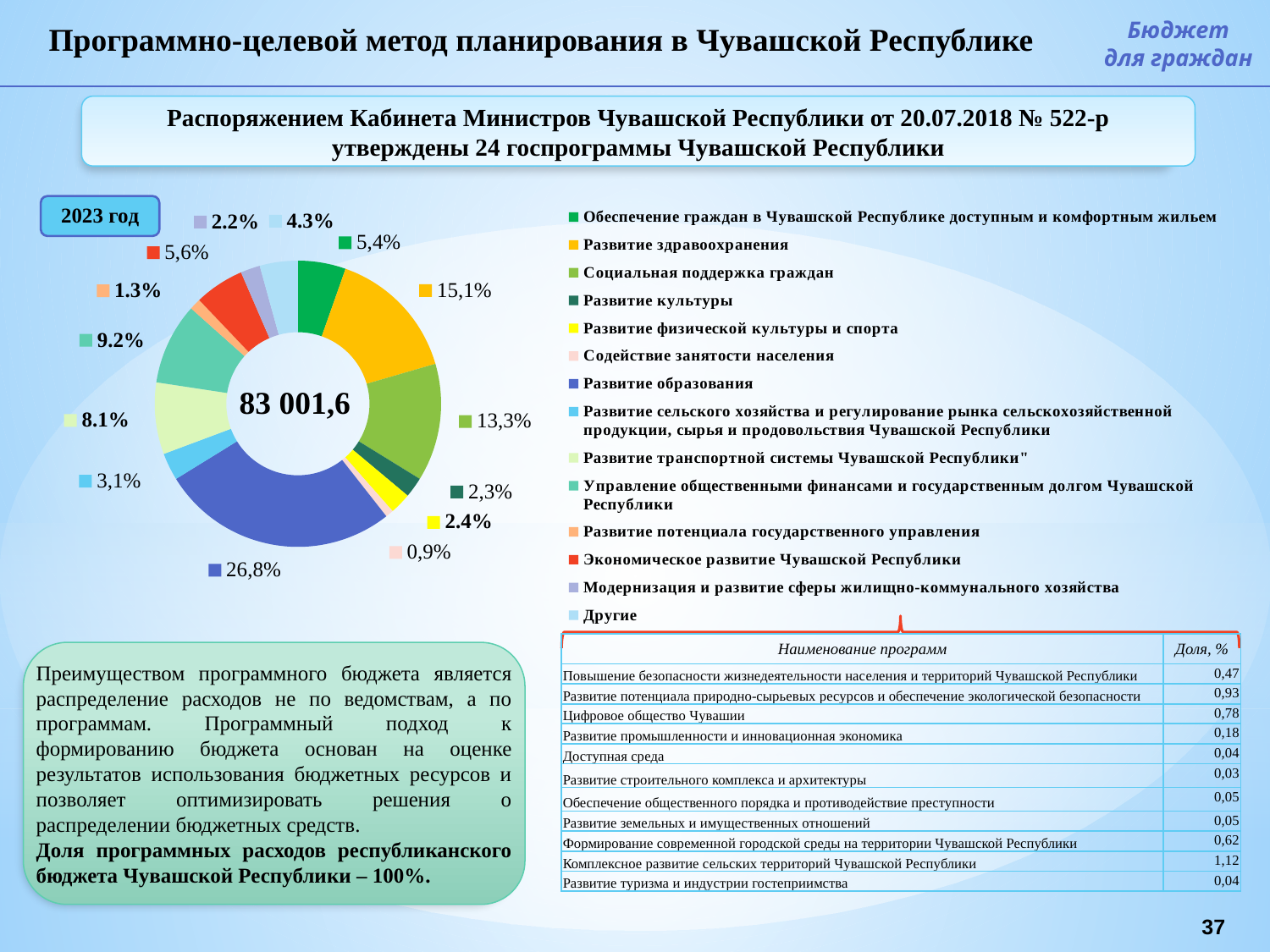
What share does Развитие образования have in the chart? 26,8% Which has a larger share: Управление общественными финансами и государственным долгом or Развитие транспортной системы? Управление общественными финансами и государственным долгом What share does Содействие занятости населения have in the chart? 0,9% What value is printed in the centre of the doughnut chart? 83 001,6 Which program has the largest share in the chart? Развитие образования By how many percentage points does Развитие здравоохранения exceed Социальная поддержка граждан? 1,8 Which program has the smallest share in the chart? Содействие занятости населения How many slices does the doughnut chart have? 14 What share does Социальная поддержка граждан have in the chart? 13,3% What share does Развитие здравоохранения have in the chart? 15,1% What type of chart is shown on the slide? Doughnut (pie) chart What share does Экономическое развитие Чувашской Республики have in the chart? 5,6%